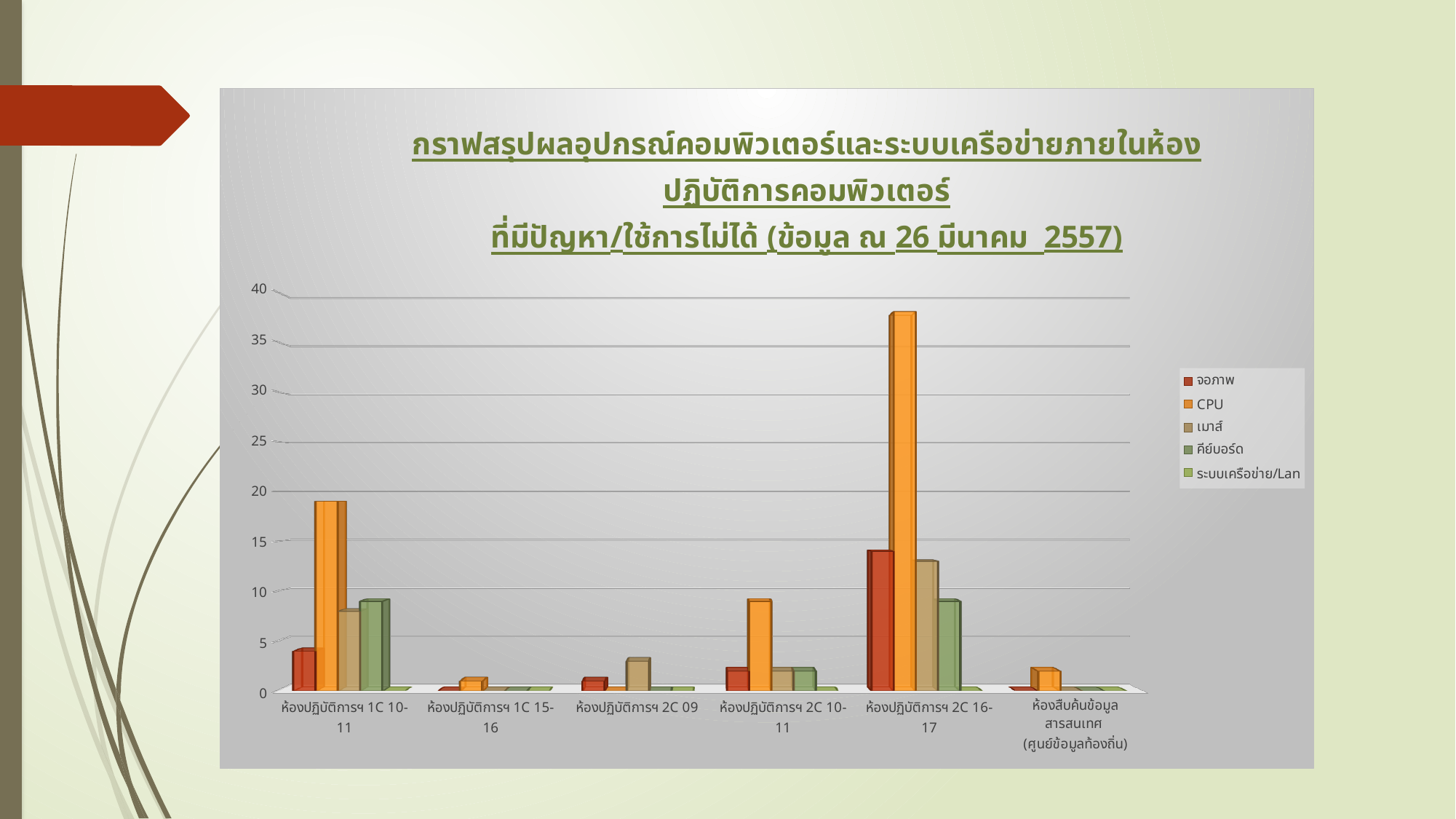
Is the CPU value for ห้องปฏิบัติการฯ 2C 10-11 greater or less than 5? greater What kind of chart is shown on the slide? bar chart How many series does the legend list? 5 Is the CPU value for ห้องปฏิบัติการฯ 2C 16-17 greater or less than 35? greater Which room has the tallest CPU bar? ห้องปฏิบัติการฯ 2C 16-17 Which room has the larger CPU bar: ห้องปฏิบัติการฯ 1C 10-11 or ห้องปฏิบัติการฯ 2C 10-11? ห้องปฏิบัติการฯ 1C 10-11 What colour represents the CPU series in the legend? orange Which series has the tallest bar anywhere in the chart? CPU Is the จอภาพ value for ห้องปฏิบัติการฯ 2C 16-17 greater or less than 10? greater For ห้องปฏิบัติการฯ 2C 16-17, which is larger: the CPU bar or the จอภาพ bar? CPU How many room categories are shown along the x axis? 6